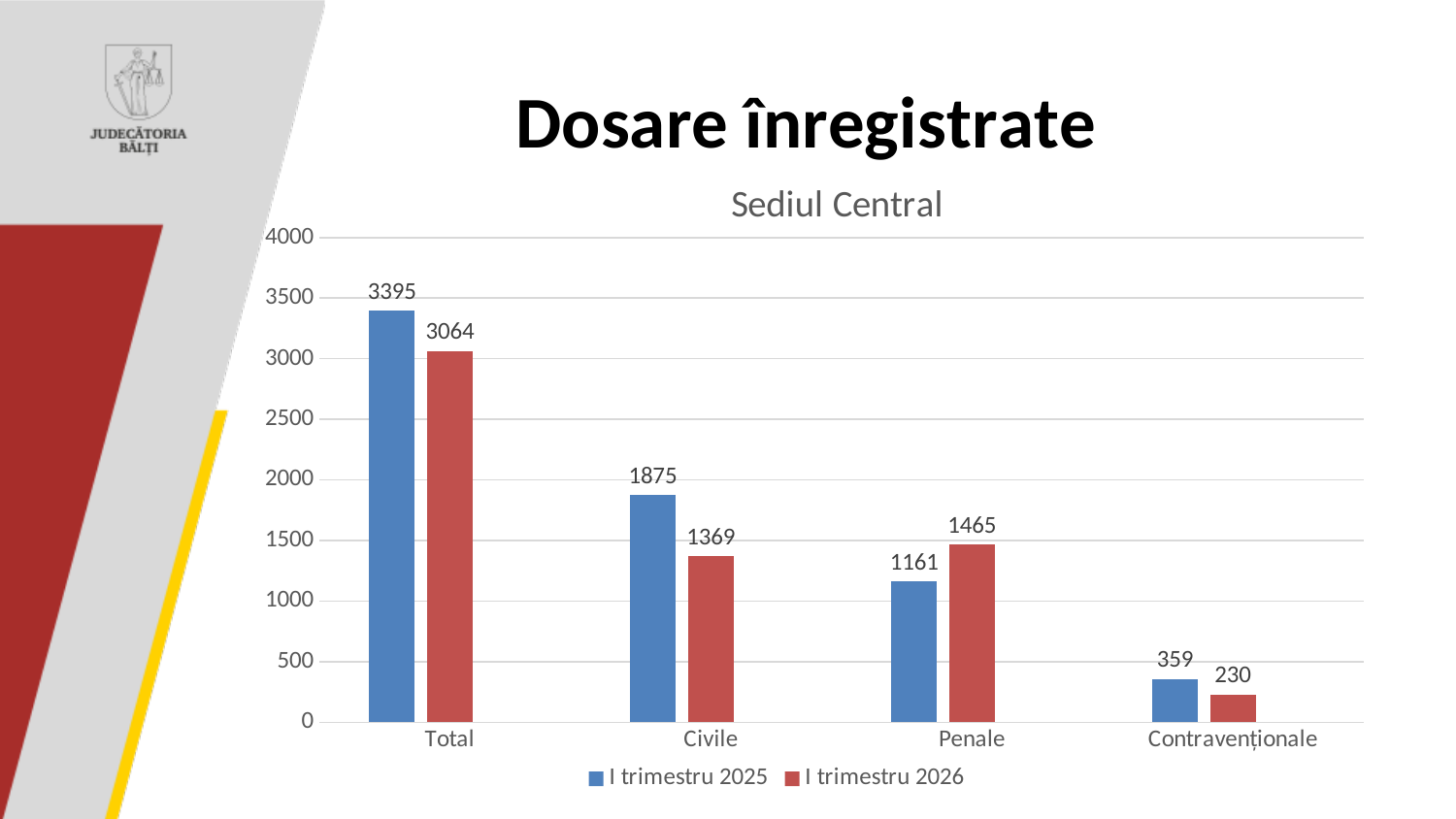
For Penale, which series has the larger value: I trimestru 2025 or I trimestru 2026? I trimestru 2026 Which category has the lowest value in the I trimestru 2025 series? Contravenționale How many series does the legend list? 2 How many categories are shown on the x axis? 4 What is the value for Penale in the I trimestru 2026 series? 1465 What is the value for Civile in the I trimestru 2025 series? 1875 What is the difference between the I trimestru 2025 and I trimestru 2026 values for Total? 331 What is the difference between the I trimestru 2025 and I trimestru 2026 values for Civile? 506 What is the title of the chart? Sediul Central What kind of chart is shown on the slide? Bar chart What is the value for Contravenționale in the I trimestru 2025 series? 359 Which category has the highest value in the I trimestru 2026 series? Total